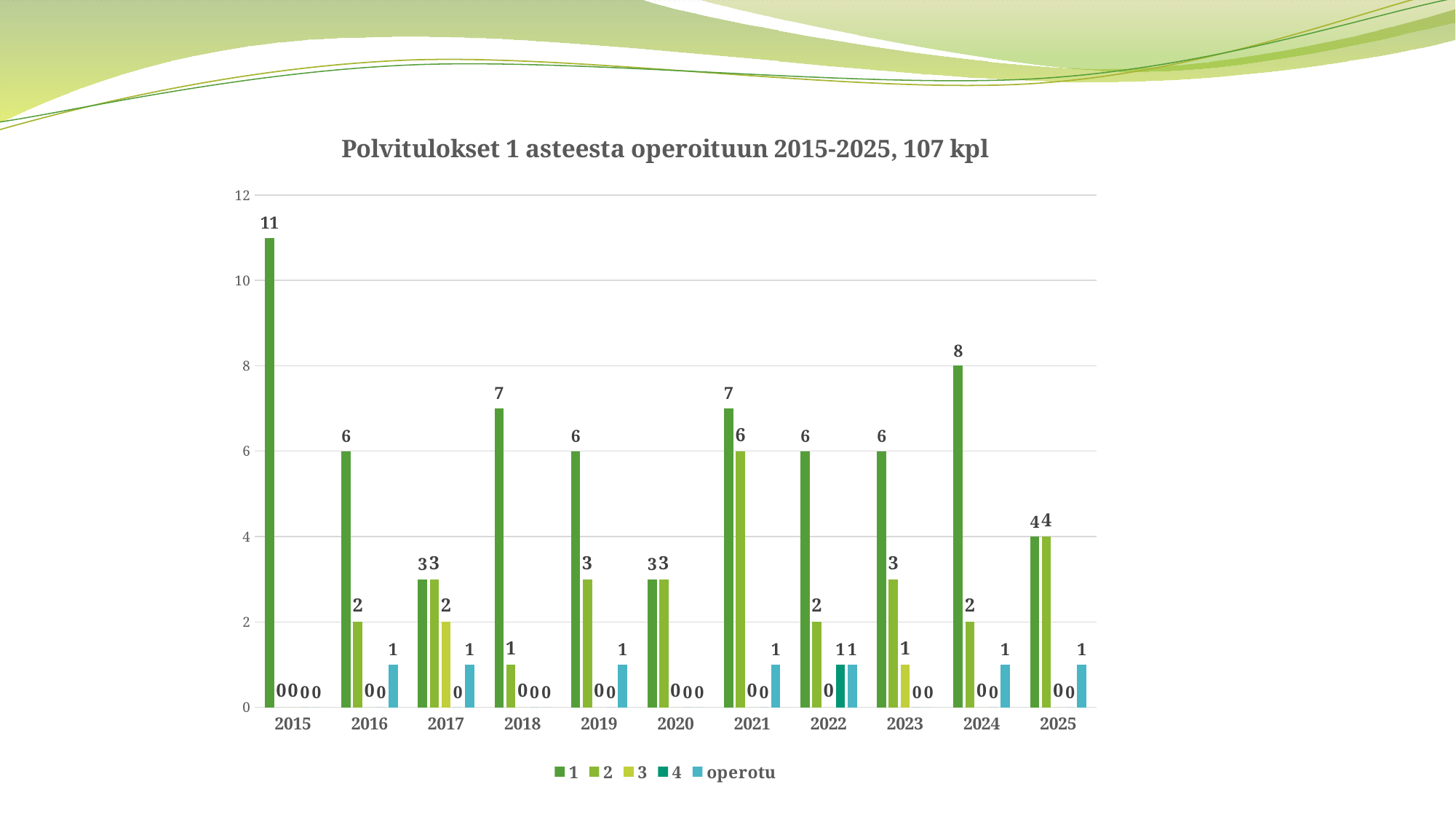
How many series does the legend list? 5 What kind of chart is shown on the slide? bar chart In which year is the value for series 2 highest? 2021 What is the value for series 1 in 2015? 11 What is the value for series 3 in 2017? 2 What is the title of the chart? Polvitulokset 1 asteesta operoituun 2015-2025, 107 kpl What is the value for series 2 in 2021? 6 How many years are shown on the x axis? 11 What is the difference between the series 1 values for 2015 and 2024? 3 In which year is the value for series 1 highest? 2015 Which is larger in 2018: the value for series 1 or the value for series 2? series 1 What is the value for series 4 in 2022? 1